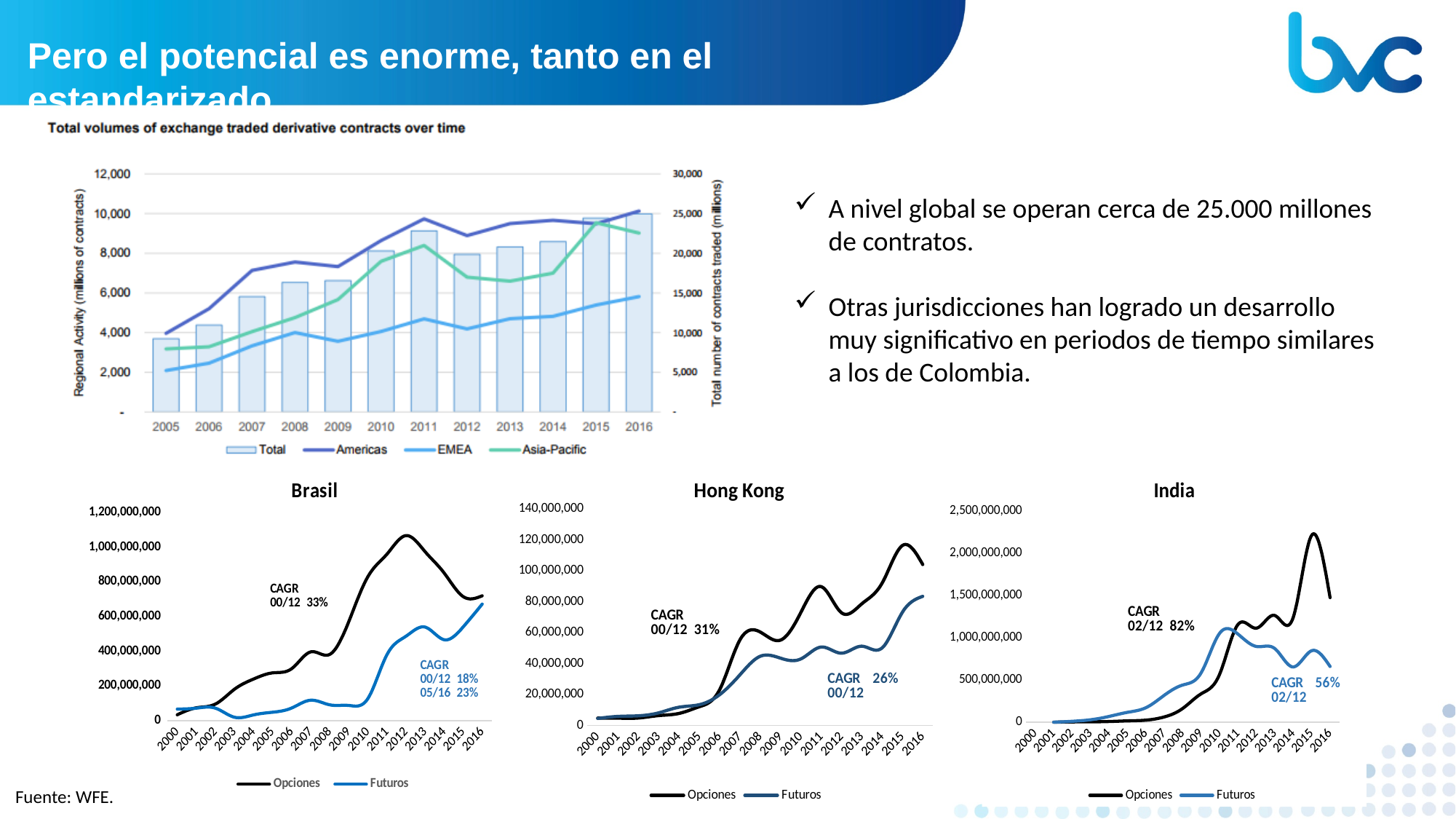
How many series does the legend of the 'Total volumes of exchange traded derivative contracts over time' chart list? 4 In the Hong Kong chart, which year has the highest Opciones value? 2015 In the India chart, which series is larger in 2010, Opciones or Futuros? Futuros In the 'Total volumes of exchange traded derivative contracts over time' chart, which year has the highest Total bar? 2016 In the 'Total volumes of exchange traded derivative contracts over time' chart, is the Asia-Pacific value for 2015 greater or less than 8,000? greater In the India chart, what CAGR for 02/12 is shown for Futuros? 56% How many years are shown on the x axis of the Brasil chart? 17 What kind of chart is the 'Total volumes of exchange traded derivative contracts over time' chart? A combined bar and line chart In the Brasil chart, is the Opciones value for 2012 greater or less than 1,000,000,000? greater In the 'Total volumes of exchange traded derivative contracts over time' chart, which year has the lowest Total bar? 2005 In the Brasil chart, what CAGR for 00/12 is shown for Opciones? 33% In the 'Total volumes of exchange traded derivative contracts over time' chart, which line is lowest across the years shown: Americas, EMEA or Asia-Pacific? EMEA